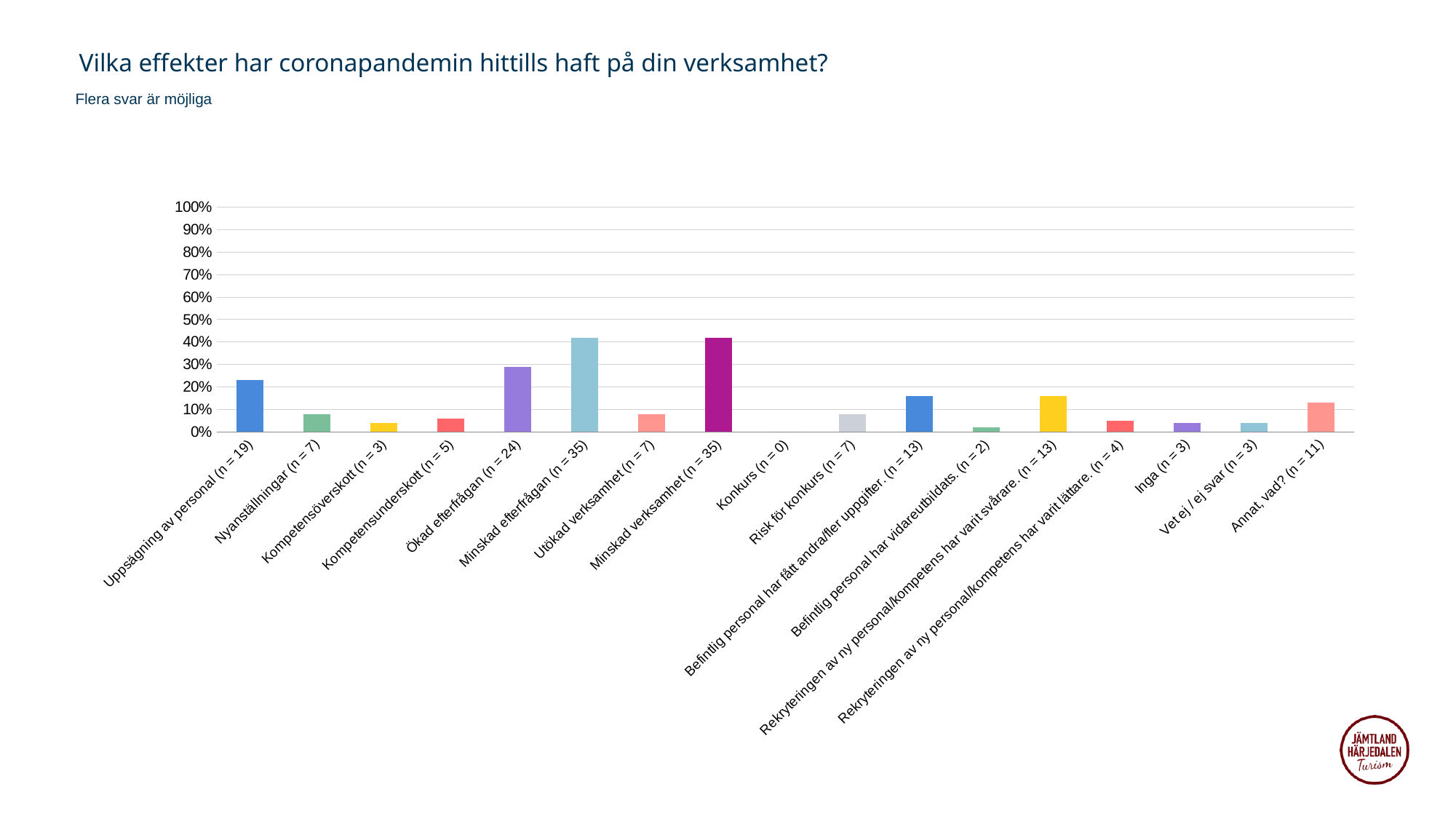
Is the value for Minskad verksamhet (n = 35) greater or less than 50%? less Is the value for Ökad efterfrågan (n = 24) greater or less than 20%? greater Is the value for Minskad efterfrågan (n = 35) greater or less than 30%? greater Which is larger: the value for Ökad efterfrågan (n = 24) or Uppsägning av personal (n = 19)? Ökad efterfrågan (n = 24) Which category has the lowest value? Konkurs (n = 0) Which is larger: the value for Nyanställningar (n = 7) or Kompetensöverskott (n = 3)? Nyanställningar (n = 7) What kind of chart is shown on the slide? bar chart How many categories are plotted along the x axis? 17 What is the value for Konkurs (n = 0)? 0% What is the title of the chart on the slide? Vilka effekter har coronapandemin hittills haft på din verksamhet?